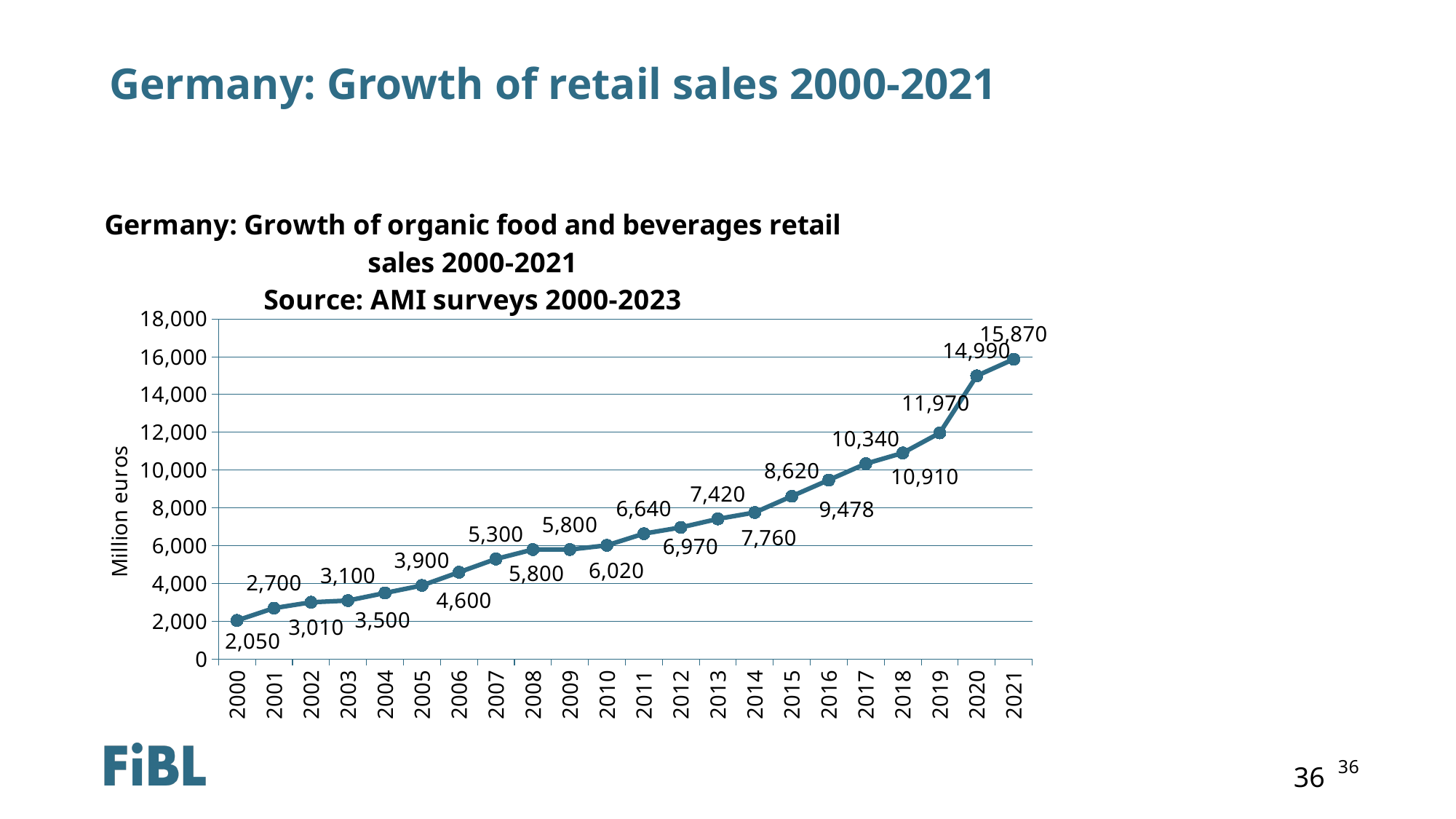
What is the value for 2016? 9,478 How many years are plotted on the chart? 22 What is the value for 2010? 6,020 What is the value for 2000? 2,050 What is the difference between the values for 2021 and 2020? 880 What kind of chart is shown? Line chart Which is larger, the value for 2015 or the value for 2013? 2015 What is the difference between the values for 2019 and 2018? 1,060 What is the label of the vertical axis? Million euros Which year has the highest value? 2021 What is the value for 2021? 15,870 Which year has the lowest value? 2000